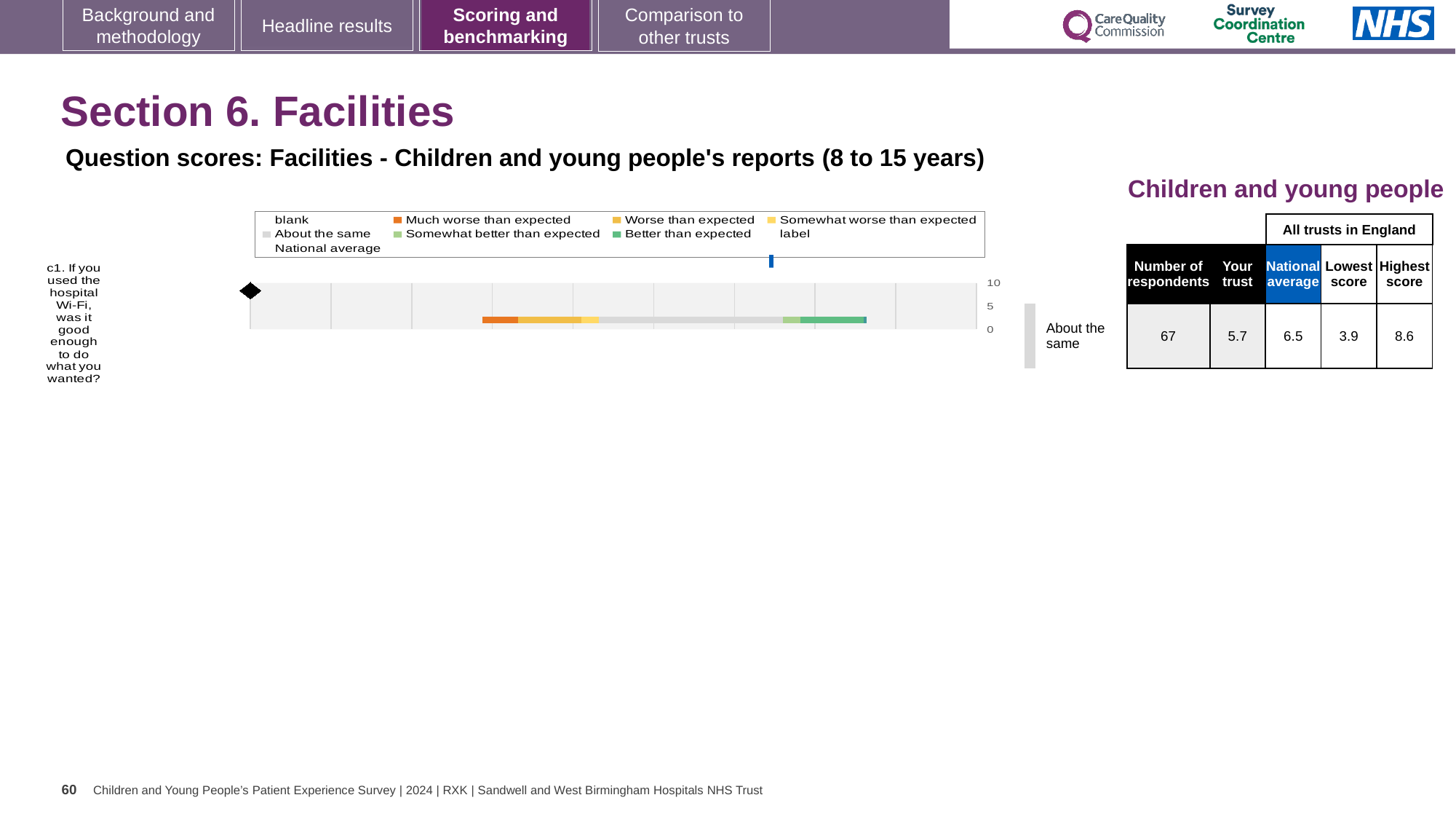
What is the highest score among all trusts in England for question c1? 8.6 What is the lowest score among all trusts in England for question c1? 3.9 What is the national average score for question c1? 6.5 How many questions (categories) are plotted on the chart? 1 What is the difference between the highest score and the lowest score for question c1? 4.7 How many respondents answered question c1? 67 Which colour in the legend represents 'Much worse than expected'? Orange What kind of chart is used to show the question score for c1? Bar chart Which is larger for question c1, the trust's score or the national average? National average What is the 'Your trust' score for question c1 about the hospital Wi-Fi? 5.7 What is the highest value shown on the chart's axis? 10 What benchmark category is the trust's score for question c1 placed in? About the same